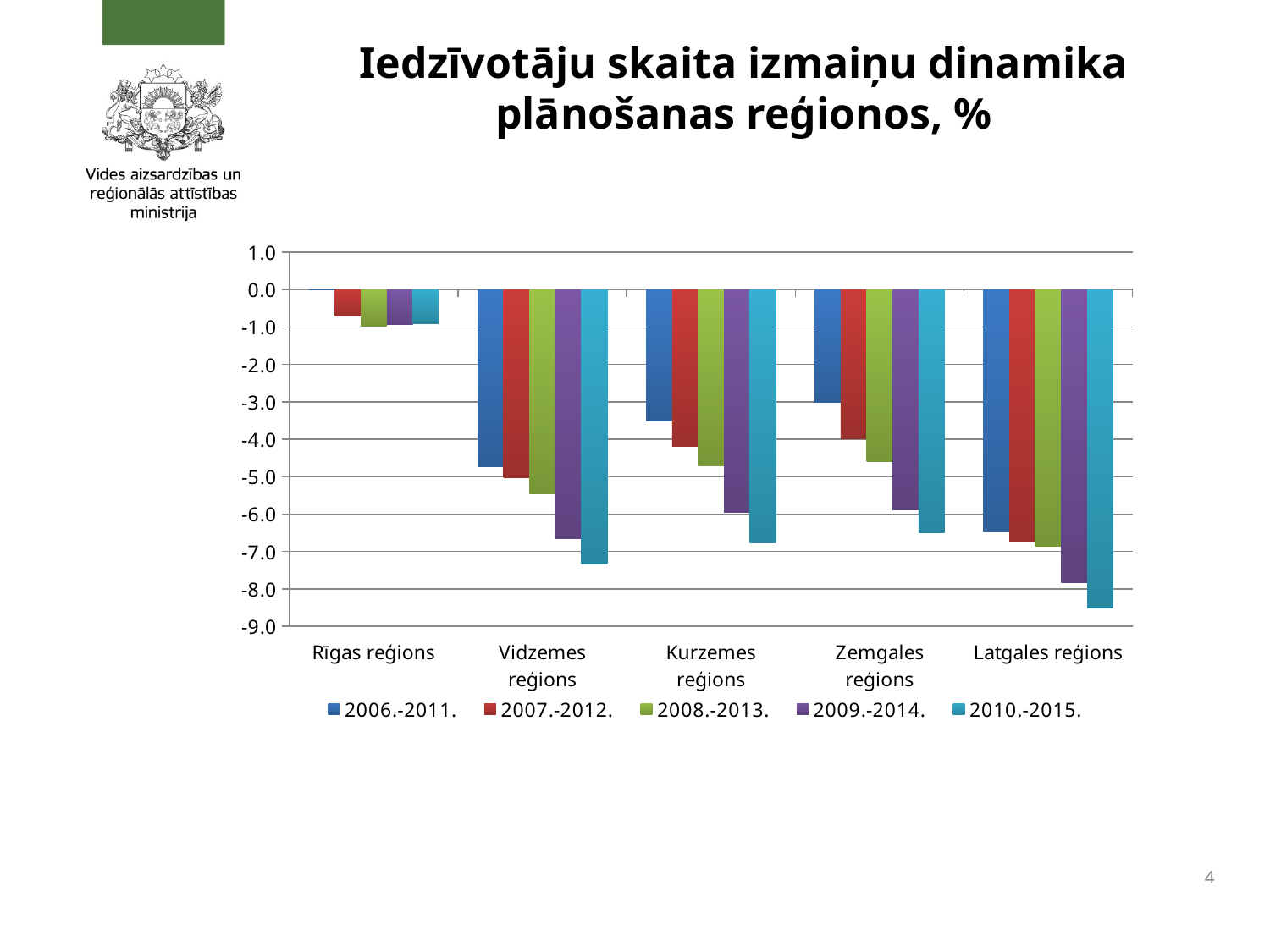
How many regions (categories) are shown on the x axis? 5 Within Latgales reģions, do the values rise or fall from the 2006.-2011. series to the 2010.-2015. series? fall How many series does the legend list? 5 Is the value for Latgales reģions in 2010.-2015. greater or less than -8.0? less What is the title of the chart on the slide? Iedzīvotāju skaita izmaiņu dinamika plānošanas reģionos, % Which region has the lowest (most negative) value for the 2010.-2015. series? Latgales reģions Is the value for Vidzemes reģions in 2010.-2015. greater or less than -7.0? less What kind of chart is shown on the slide? bar chart Is the value for Rīgas reģions in 2007.-2012. greater or less than -1.0? greater Which region has the highest (least negative) value for the 2010.-2015. series? Rīgas reģions Which is larger, the 2010.-2015. value for Kurzemes reģions or the 2010.-2015. value for Vidzemes reģions? Kurzemes reģions